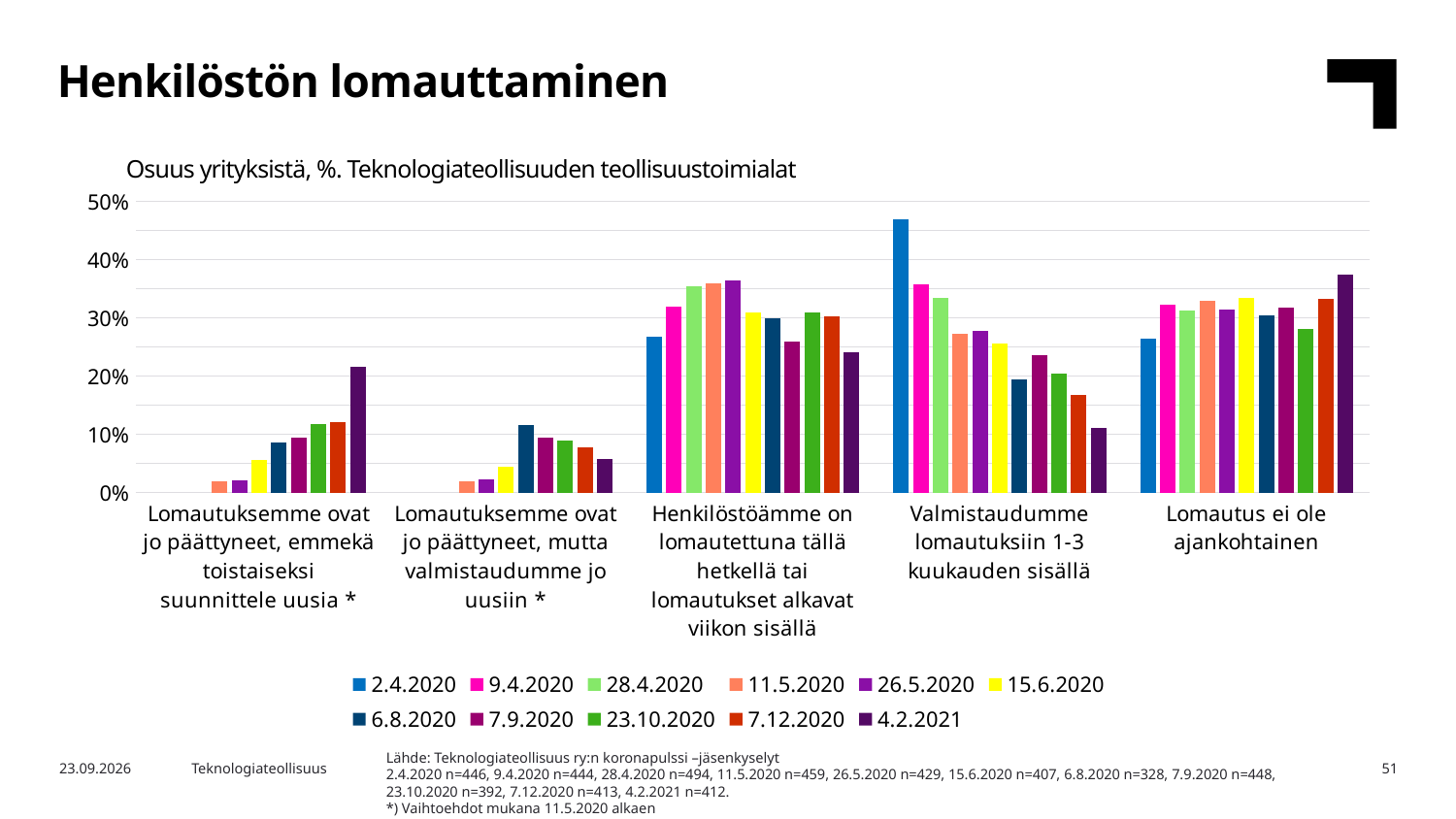
What kind of chart is shown on the slide? Bar chart Which series has the highest value in the category 'Valmistaudumme lomautuksiin 1-3 kuukauden sisällä'? 2.4.2020 How many series does the chart's legend list? 11 What is the subtitle printed above the chart? Osuus yrityksistä, %. Teknologiateollisuuden teollisuustoimialat How many categories are shown on the x axis of the chart? 5 Is the value for 2.4.2020 in the category 'Valmistaudumme lomautuksiin 1-3 kuukauden sisällä' greater or less than 40%? greater For the 2.4.2020 series, which is larger: the value for 'Henkilöstöämme on lomautettuna tällä hetkellä tai lomautukset alkavat viikon sisällä' or the value for 'Valmistaudumme lomautuksiin 1-3 kuukauden sisällä'? Valmistaudumme lomautuksiin 1-3 kuukauden sisällä In the category 'Valmistaudumme lomautuksiin 1-3 kuukauden sisällä', do the values generally rise or fall across the survey dates from 2.4.2020 to 4.2.2021? fall Which series has the lowest value in the category 'Valmistaudumme lomautuksiin 1-3 kuukauden sisällä'? 4.2.2021 Is the value for 4.2.2021 in the category 'Lomautuksemme ovat jo päättyneet, emmekä toistaiseksi suunnittele uusia *' greater or less than 10%? greater Is the value for 7.9.2020 in the category 'Henkilöstöämme on lomautettuna tällä hetkellä tai lomautukset alkavat viikon sisällä' greater or less than 30%? less Which category contains the tallest bar in the chart? Valmistaudumme lomautuksiin 1-3 kuukauden sisällä